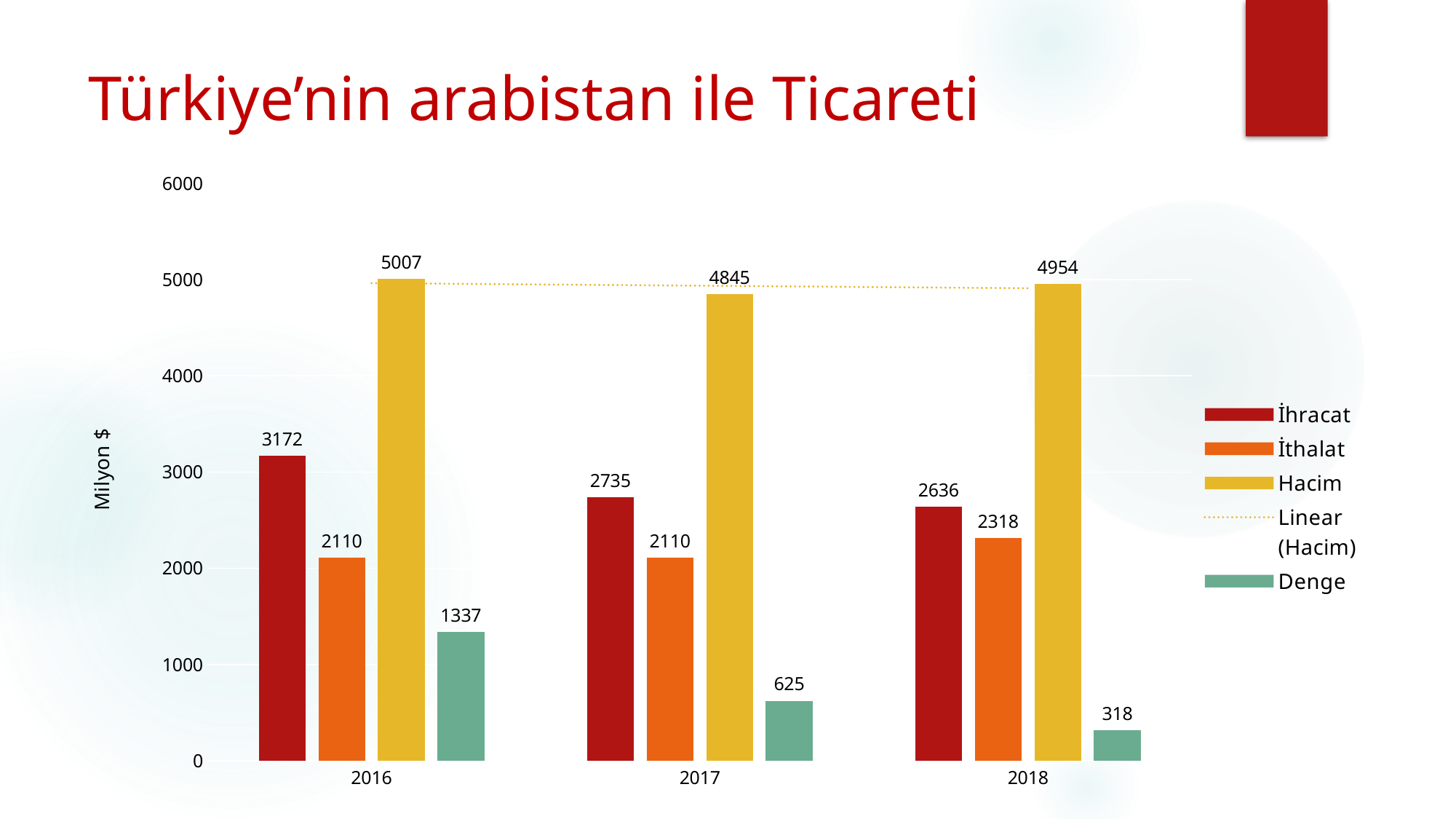
Which is larger in 2018, İhracat or İthalat? İhracat What kind of chart is shown on the slide? Bar chart What is the difference between İhracat and İthalat in 2017? 625 What is the value of Denge for 2017? 625 What is the value of Hacim for 2018? 4954 What is the value of İthalat for 2018? 2318 In which year is Hacim highest? 2016 In which year is Denge lowest? 2018 How many entries does the legend list? 5 How many years are shown on the x axis? 3 Does the Denge value rise or fall from 2016 to 2018? Fall What is the value of İhracat for 2016? 3172